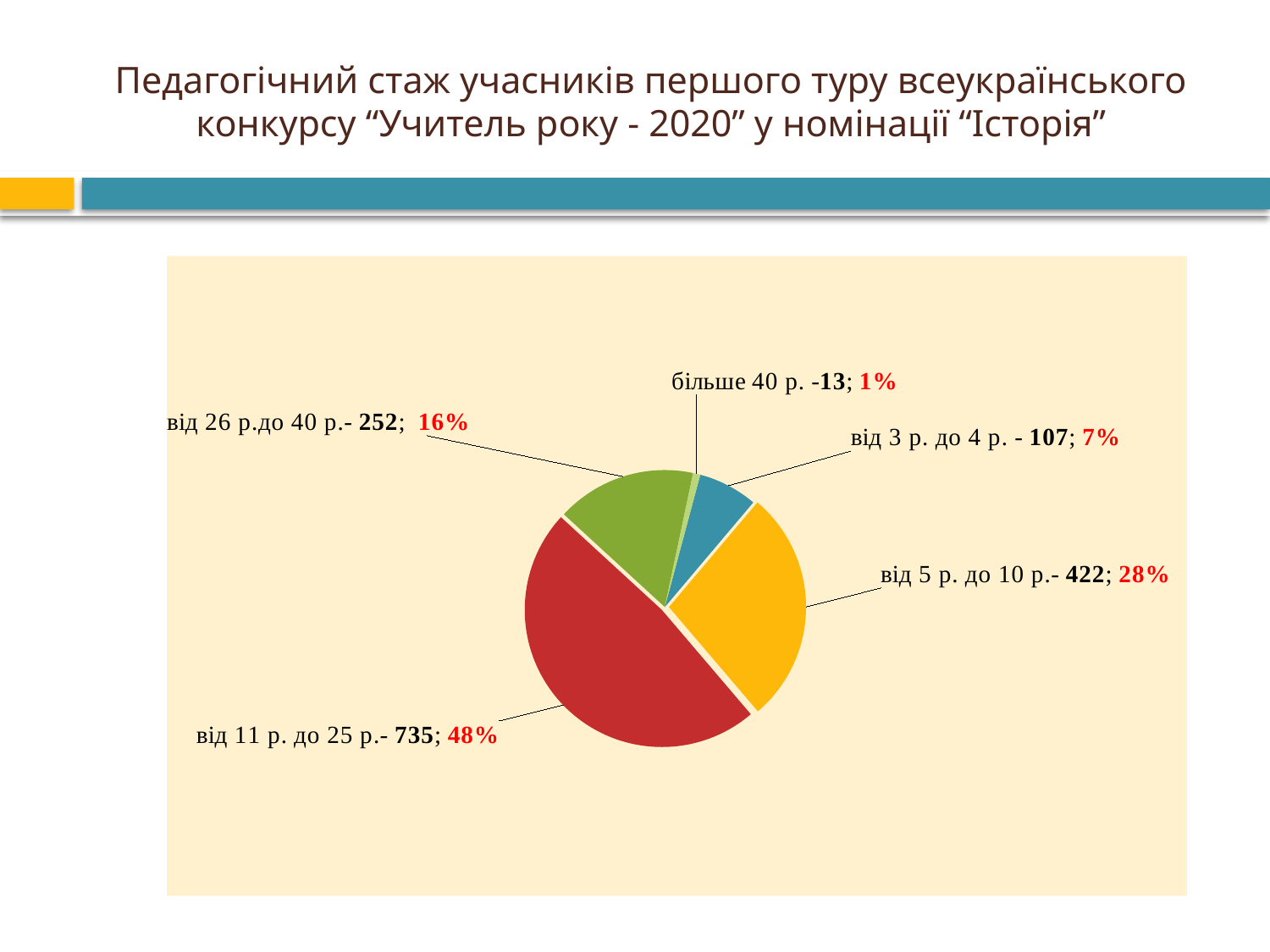
What type of chart is shown on the slide? pie chart Which is larger, the value for "від 26 р.до 40 р." or the value for "від 3 р. до 4 р."? від 26 р.до 40 р. What is the difference between the values for "від 11 р. до 25 р." and "від 5 р. до 10 р."? 313 What share of the pie does the category "від 26 р.до 40 р." represent? 16% Which category has the largest slice of the pie? від 11 р. до 25 р. Which category has the smallest slice of the pie? більше 40 р. What is the value for the category "більше 40 р."? 13 What is the value for the category "від 11 р. до 25 р."? 735 What is the value for the category "від 5 р. до 10 р."? 422 What share of the pie does the category "від 3 р. до 4 р." represent? 7% How many slices does the pie chart have? 5 What colour is the slice for "від 5 р. до 10 р."? yellow